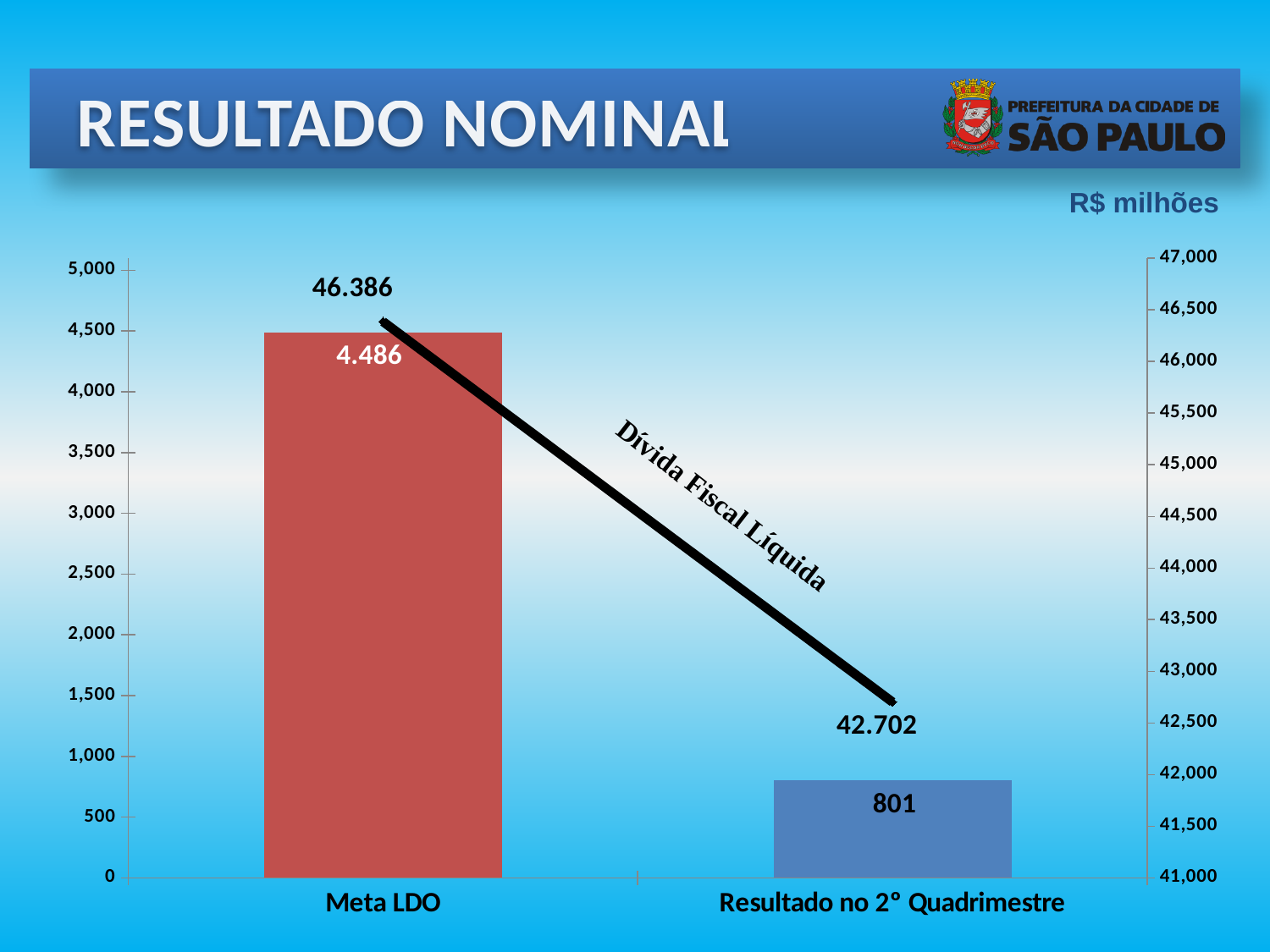
What is the Dívida Fiscal Líquida value at Resultado no 2º Quadrimestre? 42.702 Which category has the higher bar, Meta LDO or Resultado no 2º Quadrimestre? Meta LDO What is the difference between the bar values for Meta LDO and Resultado no 2º Quadrimestre? 3.685 What is the Dívida Fiscal Líquida value at Meta LDO? 46.386 What unit is indicated above the chart? R$ milhões By how much does the Dívida Fiscal Líquida line fall from Meta LDO to Resultado no 2º Quadrimestre? 3.684 How many categories are shown on the x axis? 2 Which category has the lowest bar value? Resultado no 2º Quadrimestre What is the value of the bar for Resultado no 2º Quadrimestre? 801 Does the Dívida Fiscal Líquida line rise or fall from Meta LDO to Resultado no 2º Quadrimestre? fall What is the value of the bar for Meta LDO? 4.486 What is the title of the slide containing the chart? RESULTADO NOMINAL